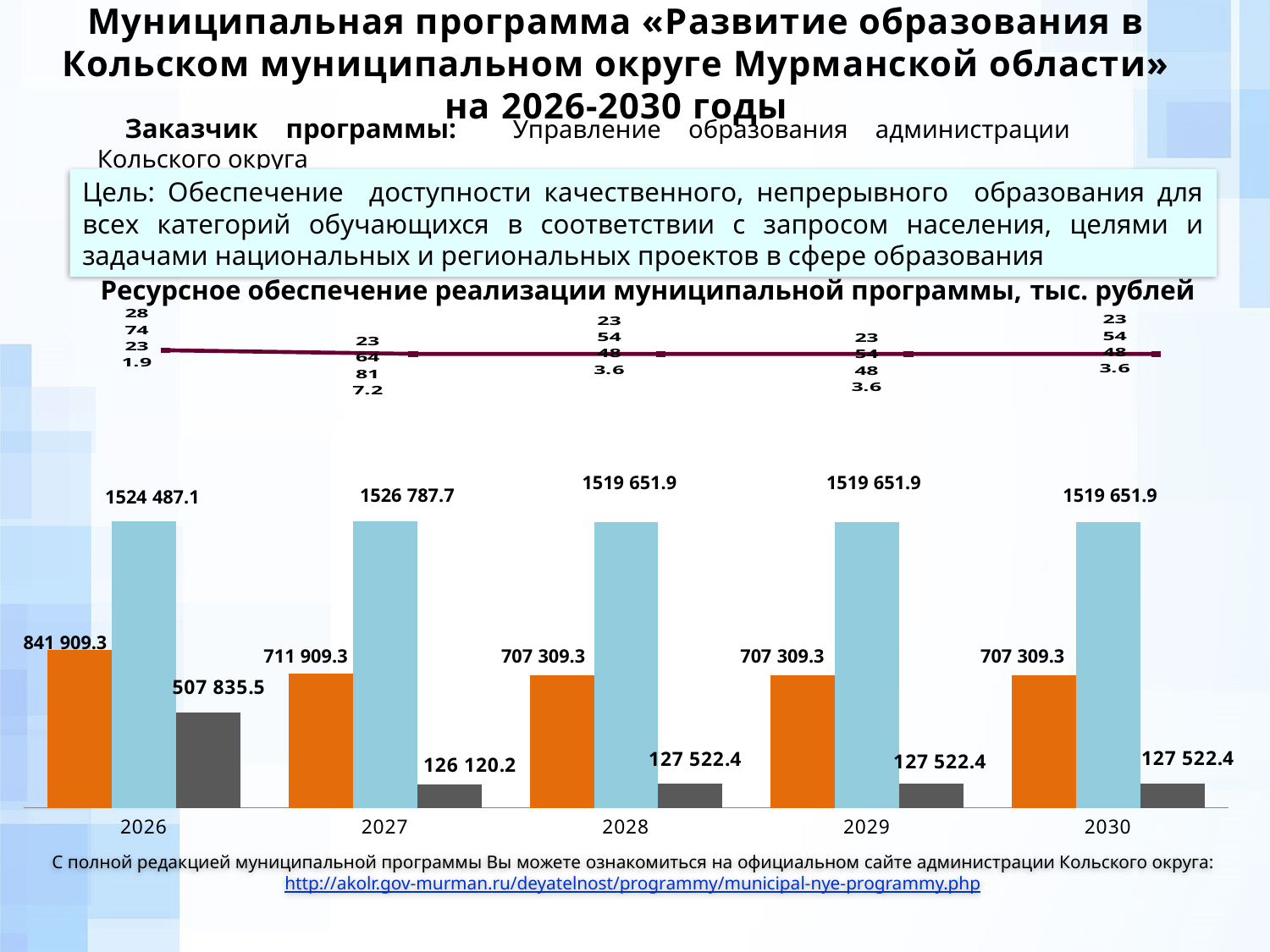
What kind of chart is used to show the resource provision by year? bar chart What is the value of the dark gray bar for 2026? 507 835.5 In which year is the orange bar the highest? 2026 In which year is the dark gray bar the lowest? 2027 What is the title of the chart on the slide? Ресурсное обеспечение реализации муниципальной программы, тыс. рублей Do the orange bar values rise or fall from 2026 to 2028? fall What is the value of the dark gray bar for 2029? 127 522.4 What is the value of the light blue bar for 2026? 1524 487.1 What is the value of the orange bar for 2027? 711 909.3 What is the difference between the orange bar values for 2026 and 2027? 130 000.0 How many years are shown on the x axis of the chart? 5 Which is larger: the light blue bar for 2027 or the light blue bar for 2026? 2027